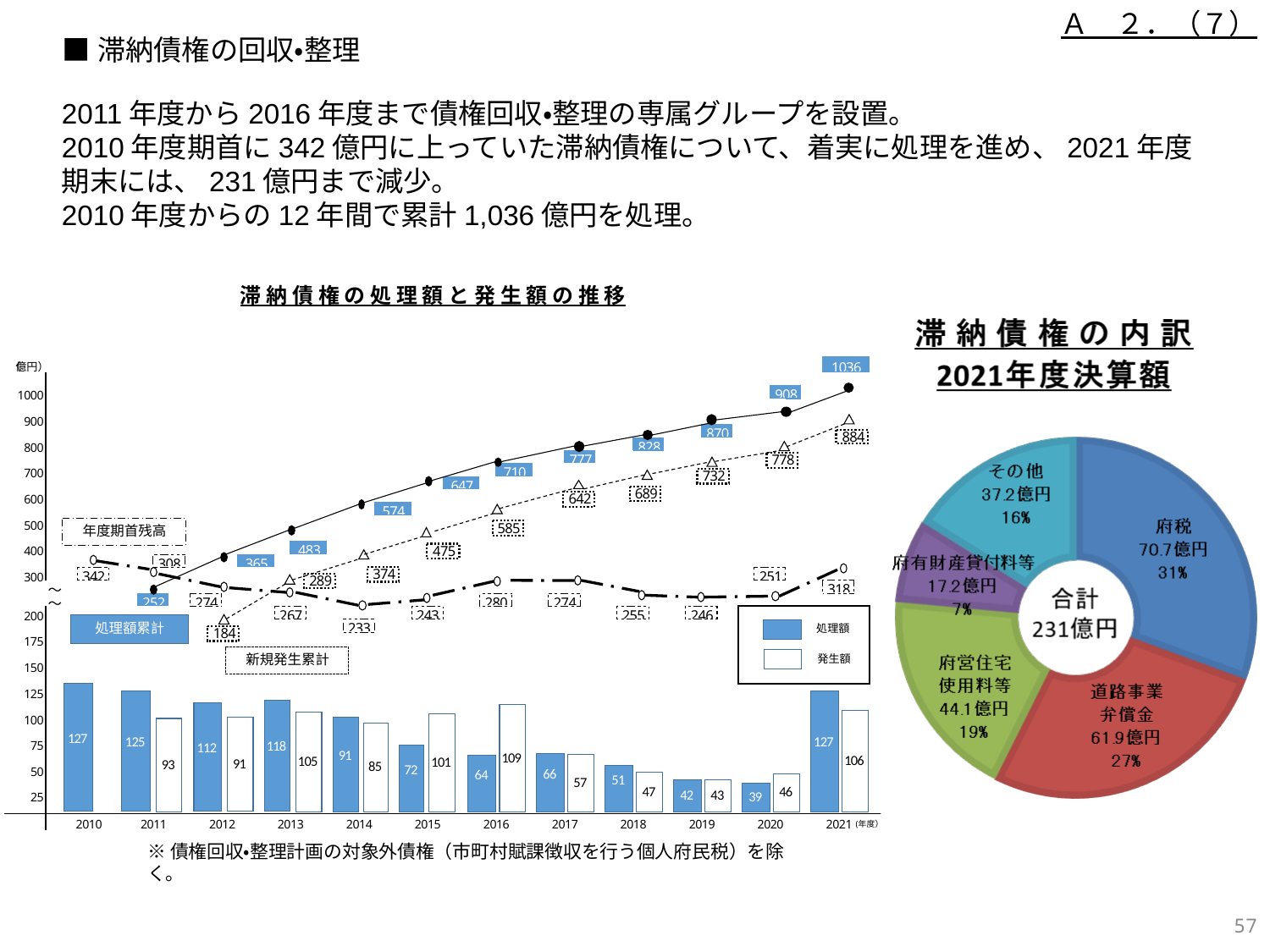
In the chart 滞納債権の処理額と発生額の推移, what is the difference between the 処理額 and 発生額 values for 2021? 21 In the chart 滞納債権の処理額と発生額の推移, what is the 処理額 value for 2010? 127 In the chart 滞納債権の処理額と発生額の推移, what is the 年度期首残高 value shown for 2010? 342 What kind of chart is 滞納債権の内訳 2021年度決算額? pie chart In the chart 滞納債権の処理額と発生額の推移, what is the 発生額 value for 2016? 109 In the chart 滞納債権の処理額と発生額の推移, what is the 処理額累計 value shown for 2021? 1036 In the chart 滞納債権の処理額と発生額の推移, how many series does the legend box list? 2 In the chart 滞納債権の処理額と発生額の推移, which is larger for 2013, 処理額 or 発生額? 処理額 In the chart 滞納債権の処理額と発生額の推移, how many years are shown on the x axis? 12 In the chart 滞納債権の処理額と発生額の推移, which year has the lowest 処理額 bar? 2020 In the chart 滞納債権の内訳 2021年度決算額, what share does 府税 have? 31% In the chart 滞納債権の内訳 2021年度決算額, which category has the largest slice? 府税